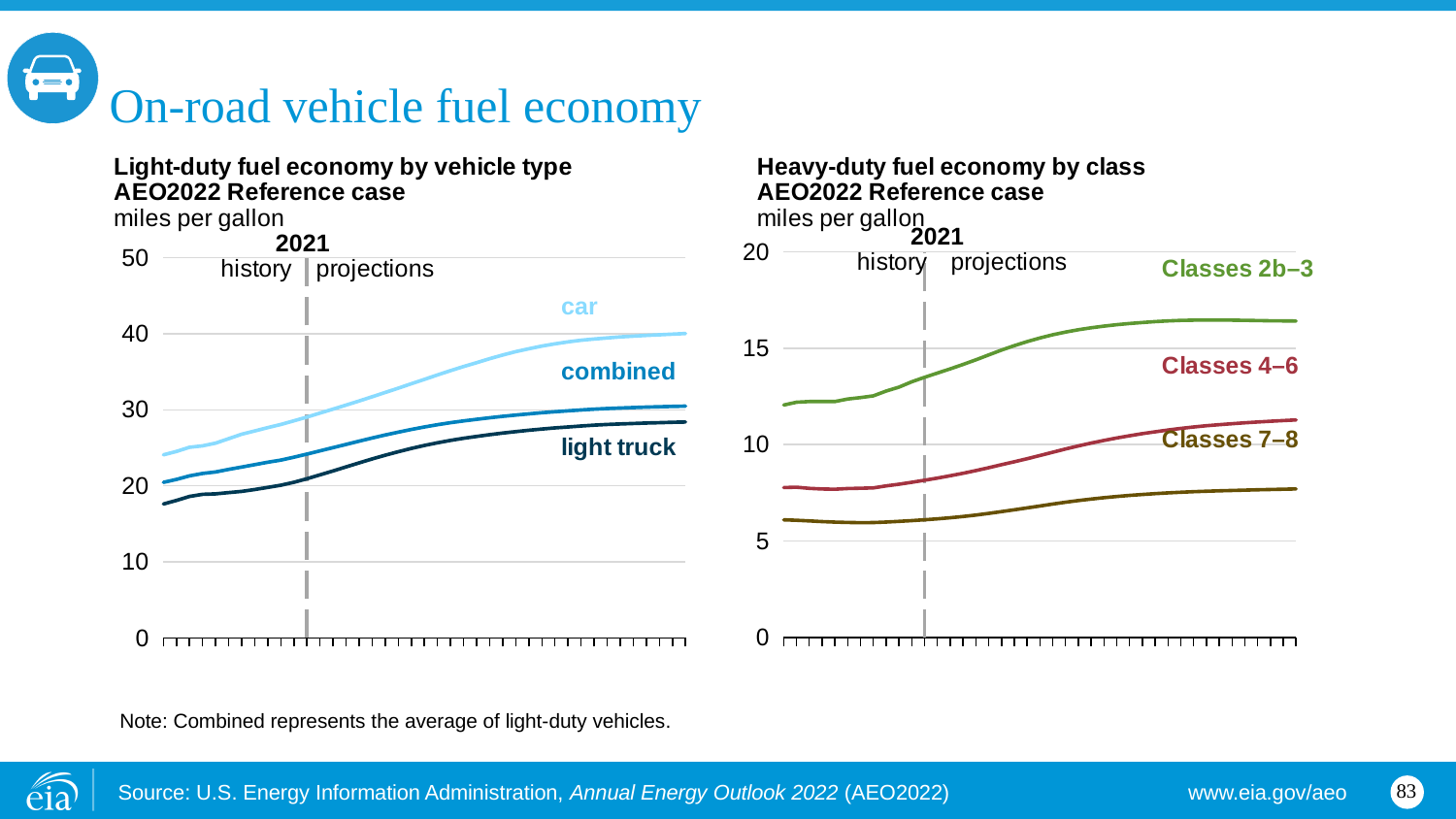
On the 'Heavy-duty fuel economy by class' chart, is the value for Classes 7–8 at the end of the projection period greater or less than 10 miles per gallon? less What unit is used on the y axis of both charts? miles per gallon What kind of chart is the 'Light-duty fuel economy by vehicle type' chart on the left? line chart On the 'Light-duty fuel economy by vehicle type' chart, which series has the highest fuel economy at the end of the projection period? car On the 'Heavy-duty fuel economy by class' chart, does the fuel economy for Classes 2b–3 rise or fall over the projection period? rise On the 'Heavy-duty fuel economy by class' chart, which class has the highest fuel economy? Classes 2b–3 How many series are plotted on the 'Heavy-duty fuel economy by class' chart? 3 On the 'Light-duty fuel economy by vehicle type' chart, is the value for light truck at the start of the history period greater or less than 20 miles per gallon? less On the 'Light-duty fuel economy by vehicle type' chart, which series has the lowest fuel economy throughout the period? light truck On the 'Light-duty fuel economy by vehicle type' chart, is the value for car at the end of the projection period greater or less than 30 miles per gallon? greater How many series are plotted on the 'Light-duty fuel economy by vehicle type' chart? 3 On the 'Heavy-duty fuel economy by class' chart, which class has the lowest fuel economy? Classes 7–8